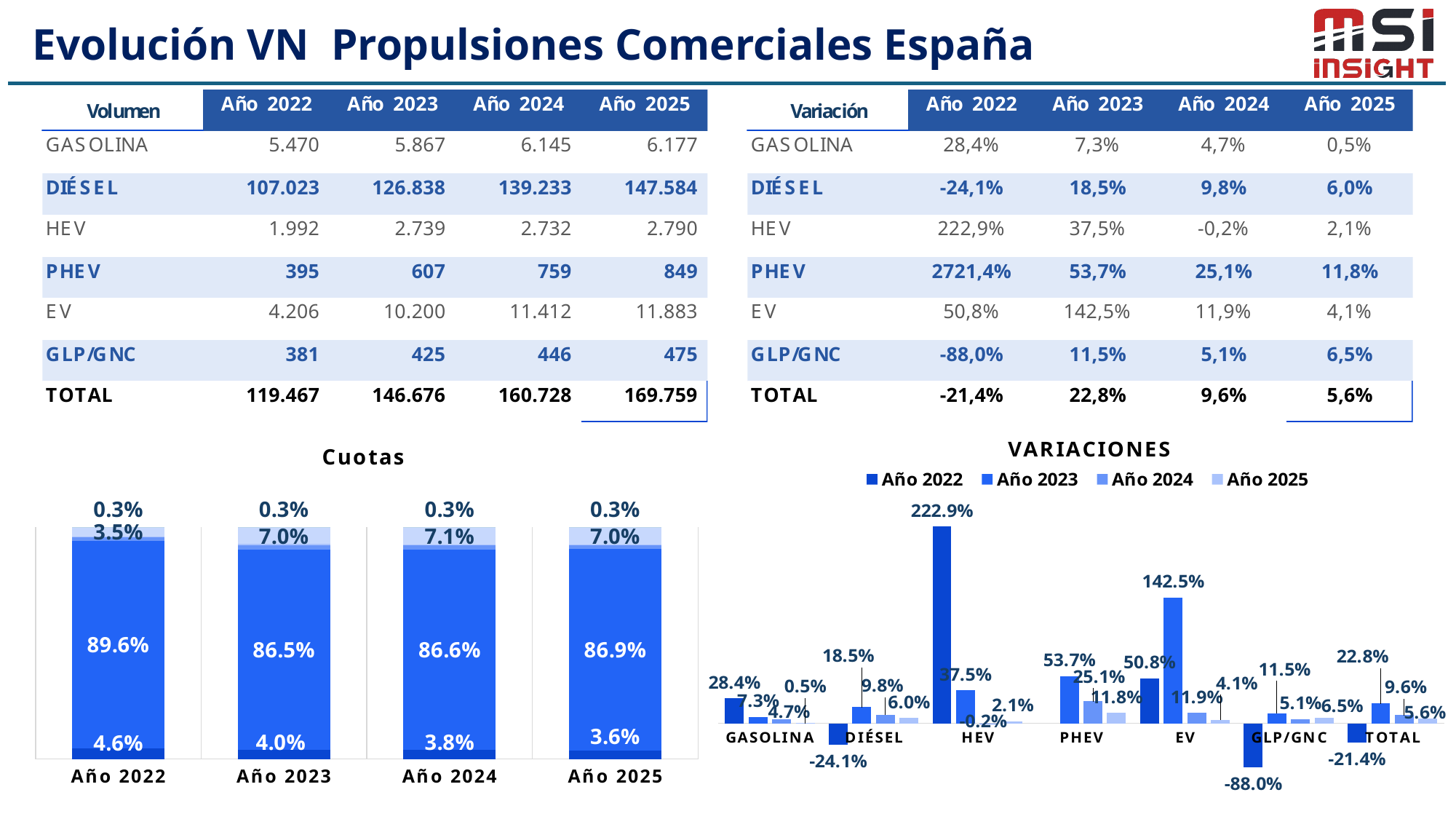
What kind of chart is the VARIACIONES chart? bar chart In the Cuotas chart, what is the value of the largest segment of the Año 2022 bar? 89.6% In the VARIACIONES chart, what is the Año 2022 value for HEV? 222.9% In the VARIACIONES chart, which category has the lowest Año 2022 value? GLP/GNC In the VARIACIONES chart, which category has the highest Año 2022 value? HEV In the VARIACIONES chart, which is larger for Año 2023: DIÉSEL or GLP/GNC? DIÉSEL In the VARIACIONES chart, what is the Año 2022 value for GLP/GNC? -88.0% In the Cuotas chart, does the bottom segment value rise or fall from Año 2022 to Año 2025? fall In the VARIACIONES chart, what is the difference between the TOTAL values for Año 2023 and Año 2024? 13.2% In the VARIACIONES chart, what is the Año 2023 value for EV? 142.5% How many series does the legend of the VARIACIONES chart list? 4 How many categories are shown on the x axis of the VARIACIONES chart? 7